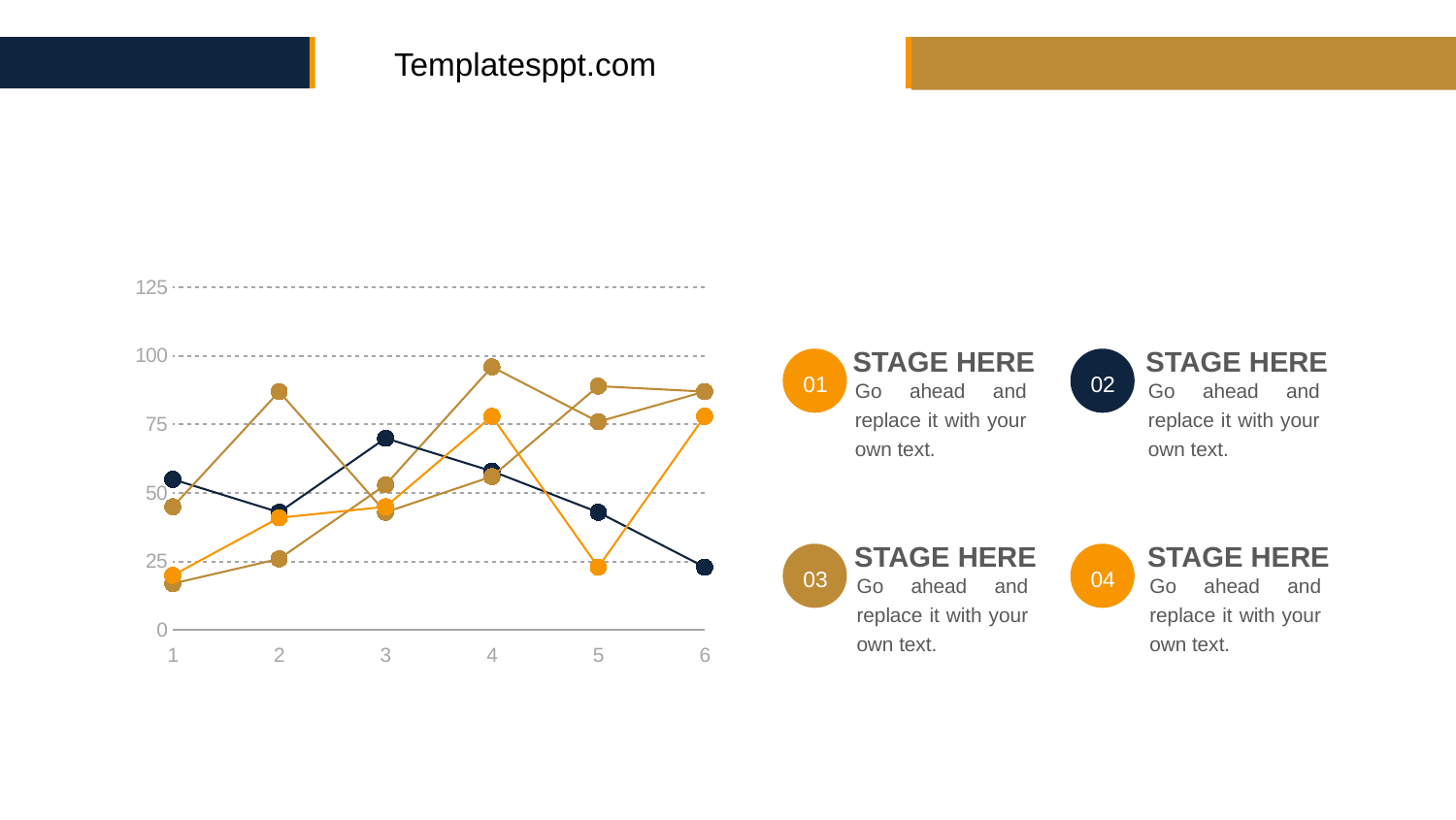
Does the dark navy line rise or fall from x = 4 to x = 6? fall Is the value of the orange line at x = 4 greater or less than 50? greater Is the value of the orange line at x = 1 greater or less than 25? less Is the value of the dark navy line at x = 3 greater or less than 50? greater How many points are there along the x axis of the chart? 6 What kind of chart is shown on the slide? line chart At which x value does the dark navy line reach its lowest point? 6 At which x value does the dark navy line reach its highest point? 3 What is the highest value shown on the y axis of the chart? 125 How many lines are plotted on the chart? 4 For the dark navy line, is the value at x = 3 or at x = 6 larger? x = 3